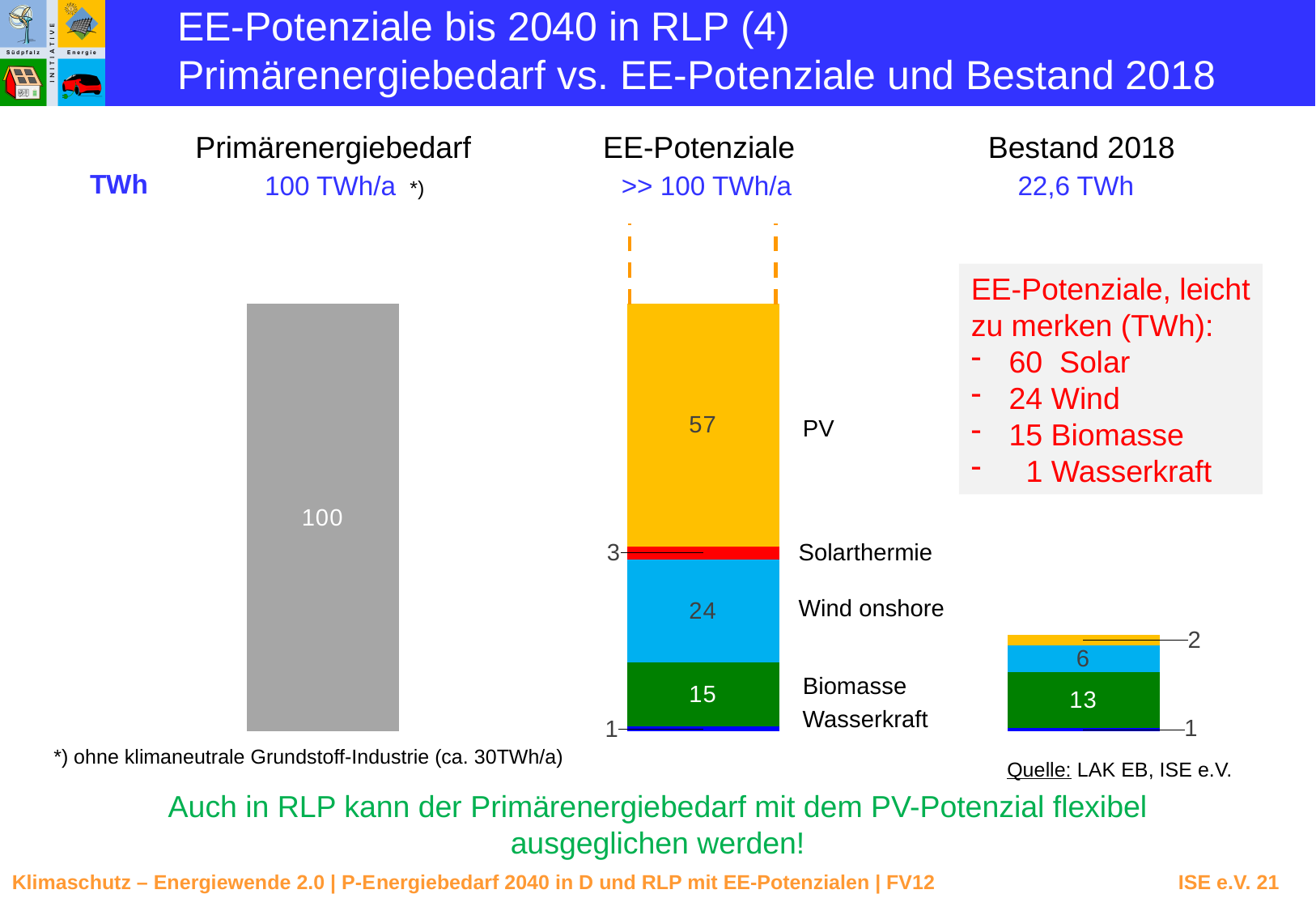
In the EE-Potenziale chart, what is the value of the Wind onshore segment? 24 In the EE-Potenziale chart, what is the difference between the PV segment and the Wind onshore segment? 33 In the EE-Potenziale chart, what is the value of the Solarthermie segment? 3 In the Bestand 2018 chart, what is the value of the green (Biomasse) segment? 13 In the EE-Potenziale chart, which segment is the largest? PV In the EE-Potenziale chart, what is the value of the Biomasse segment? 15 In the Bestand 2018 chart, which is larger, the blue (Wind) segment or the green (Biomasse) segment? Biomasse In the Primärenergiebedarf chart, what value is printed on the grey bar? 100 In the EE-Potenziale chart, what is the value of the Wasserkraft segment? 1 In the EE-Potenziale chart, what is the value of the PV segment? 57 In the EE-Potenziale chart, what is the total of the stacked bar? 100 In the EE-Potenziale chart, which segment is the smallest? Wasserkraft